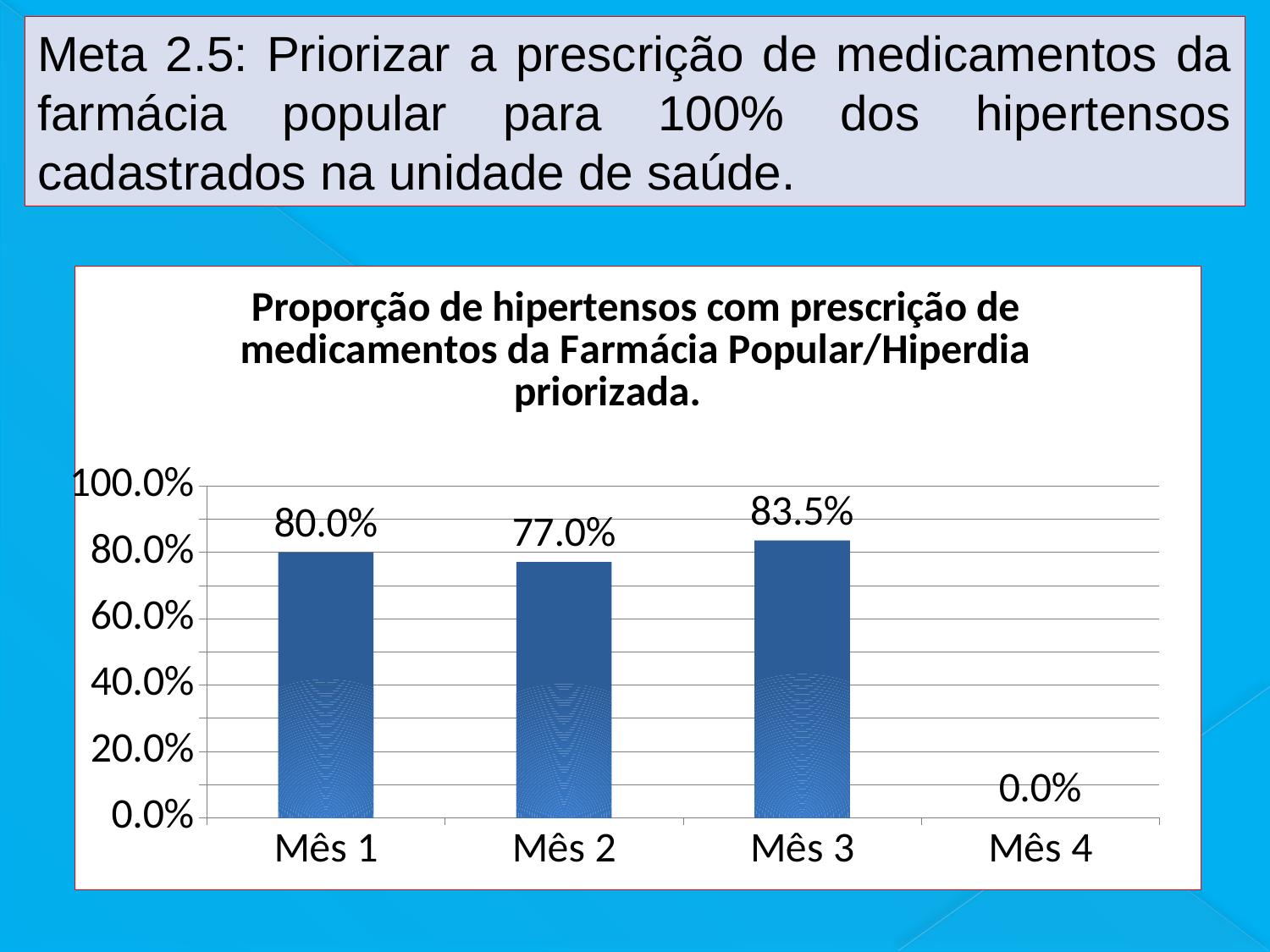
Is the value for Mês 3 greater or less than 80.0%? greater What is the value for Mês 4? 0.0% Which month has the lowest value? Mês 4 What is the value for Mês 3? 83.5% How many months are shown on the x axis? 4 Which month has the highest value? Mês 3 What kind of chart is shown on the slide? bar chart What is the value for Mês 1? 80.0% What is the title of the chart? Proporção de hipertensos com prescrição de medicamentos da Farmácia Popular/Hiperdia priorizada. What is the value for Mês 2? 77.0% What is the difference between the values for Mês 3 and Mês 2? 6.5% Which is larger, the value for Mês 1 or the value for Mês 2? Mês 1